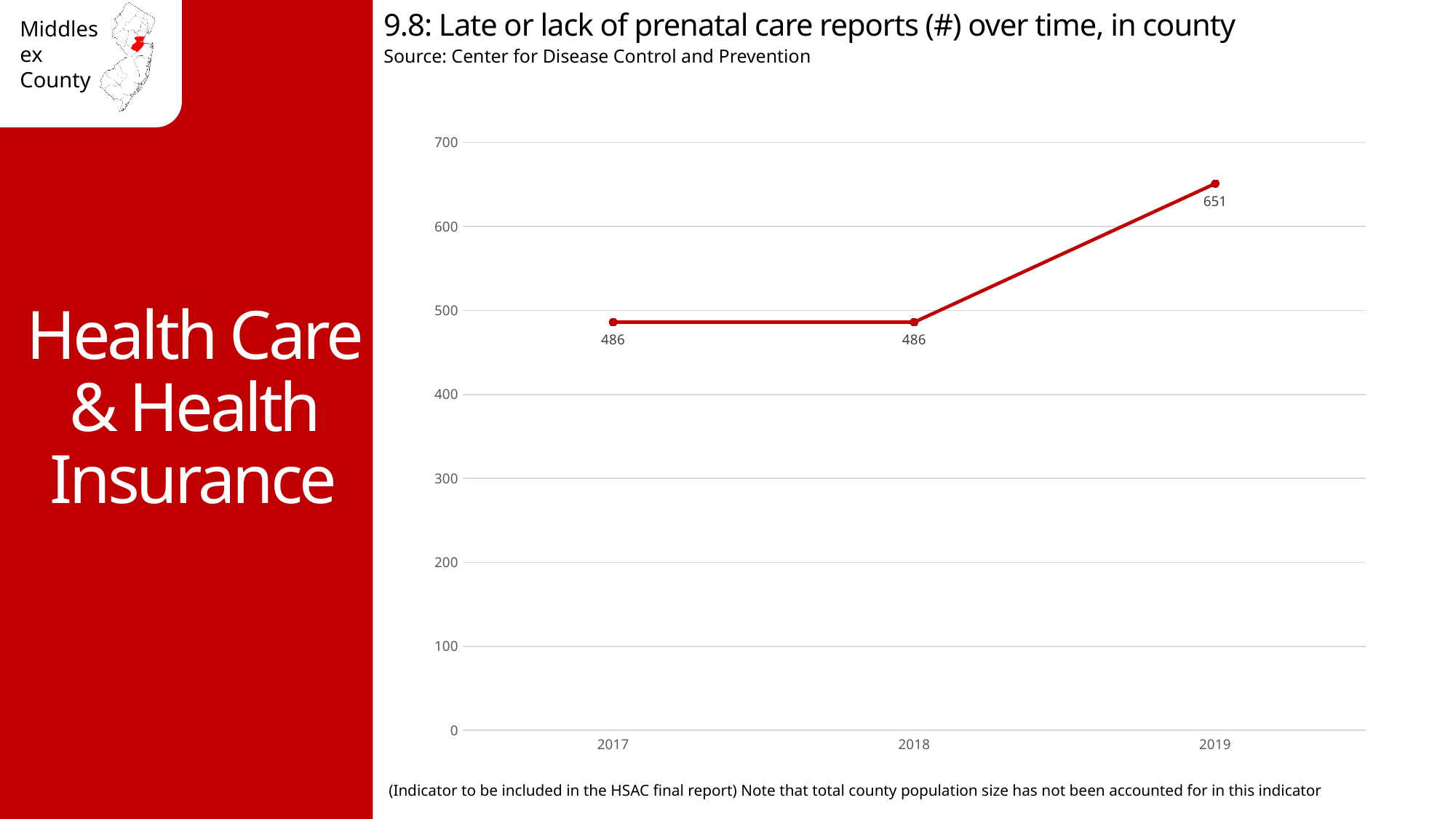
What is the source of the data shown in the chart? Center for Disease Control and Prevention Which year has the highest number of late or lack of prenatal care reports? 2019 Do the values rise or fall from 2018 to 2019? rise Is the value for 2019 greater or less than 600? greater What is the difference between the 2019 and 2018 values? 165 Is the value for 2017 greater or less than 500? less What is the number of late or lack of prenatal care reports in 2019? 651 Which is larger, the value for 2019 or the value for 2017? 2019 What is the number of late or lack of prenatal care reports in 2018? 486 What is the number of late or lack of prenatal care reports in 2017? 486 How many years are plotted on the chart? 3 What kind of chart is shown on the slide? line chart